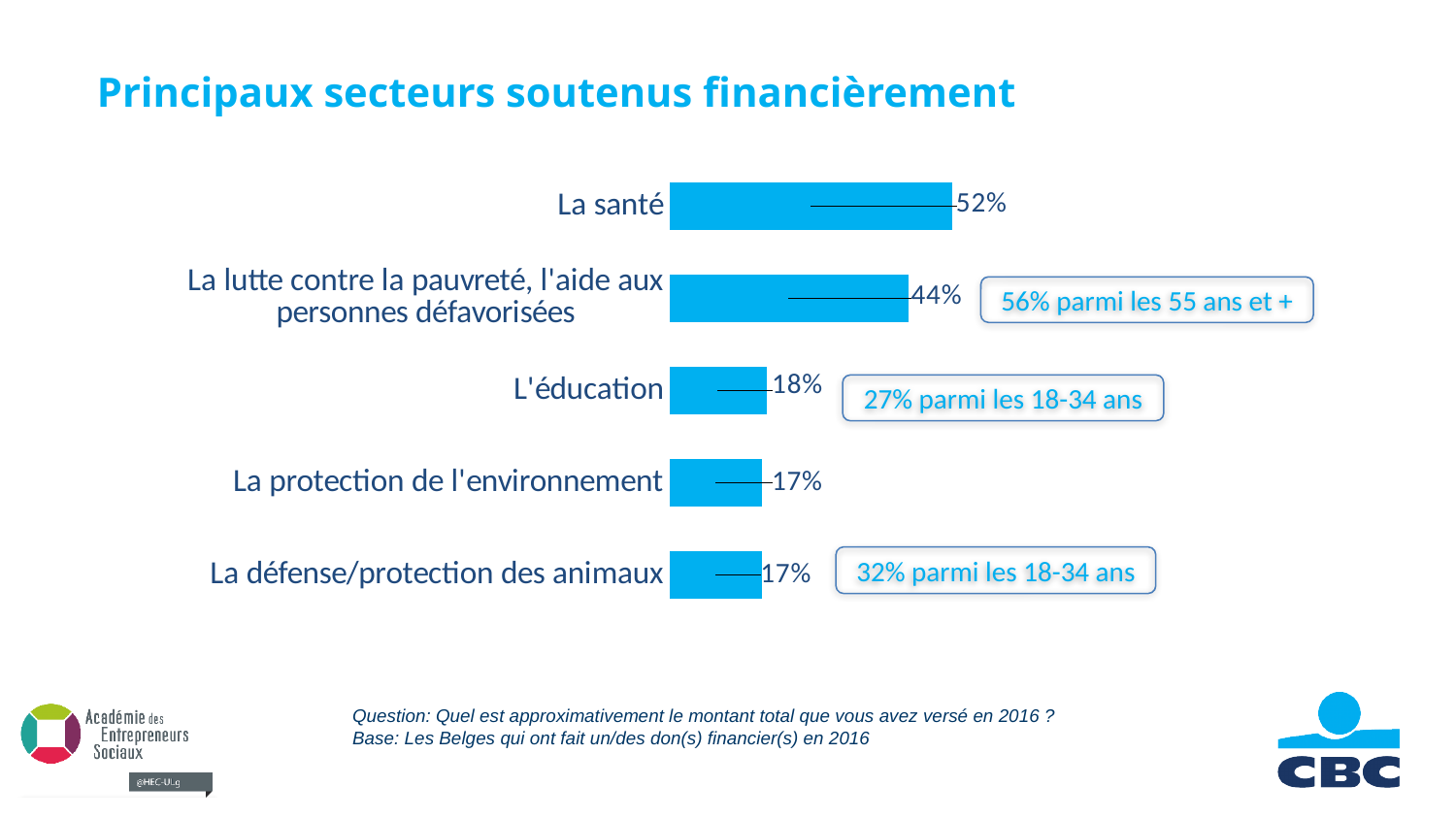
What is the value for La protection de l'environnement? 17% Which is larger, the value for La santé or the value for L'éducation? La santé What is the difference between the values for La santé and La lutte contre la pauvreté, l'aide aux personnes défavorisées? 8% What is the difference between the values for L'éducation and La protection de l'environnement? 1% How many categories are shown in the chart? 5 What is the value for La santé? 52% What is the title of the chart? Principaux secteurs soutenus financièrement According to the callout next to L'éducation, what is the value among 18-34 year olds? 27% What kind of chart is shown on the slide? Bar chart What is the value for La lutte contre la pauvreté, l'aide aux personnes défavorisées? 44% What is the value for L'éducation? 18% Which category has the highest value? La santé